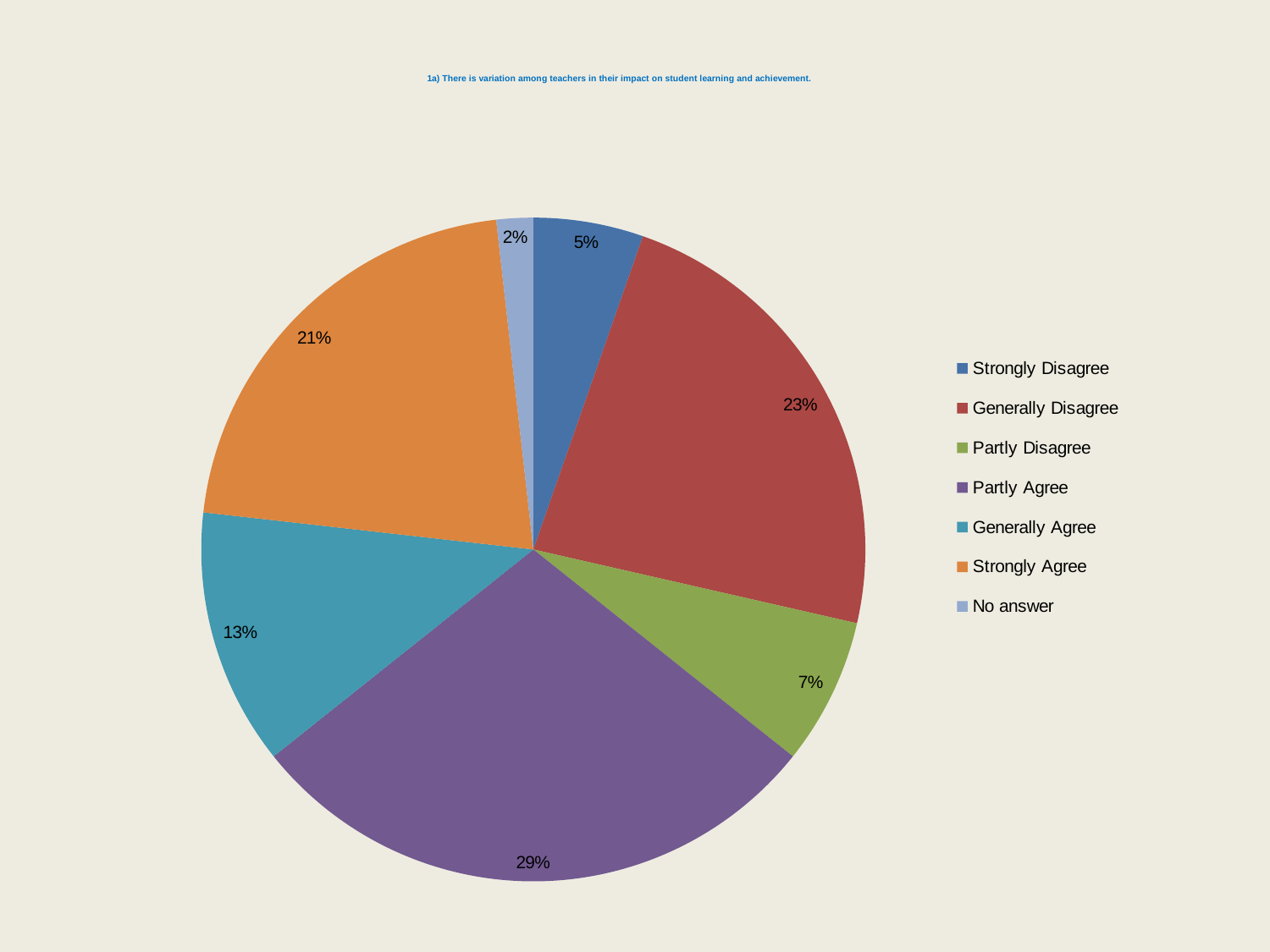
What type of chart is shown on the slide? pie chart What percentage of respondents chose Strongly Agree? 21% What percentage of respondents chose Partly Agree? 29% What is the difference in percentage points between Partly Agree and Strongly Disagree? 24 What percentage of respondents gave No answer? 2% What percentage of respondents chose Generally Disagree? 23% Which is larger, the share for Generally Disagree or the share for Strongly Agree? Generally Disagree What colour is the Partly Disagree slice? green What percentage of respondents chose Generally Agree? 13% How many categories does the legend list? 7 Which response category has the smallest share of the pie? No answer Which response category has the largest share of the pie? Partly Agree